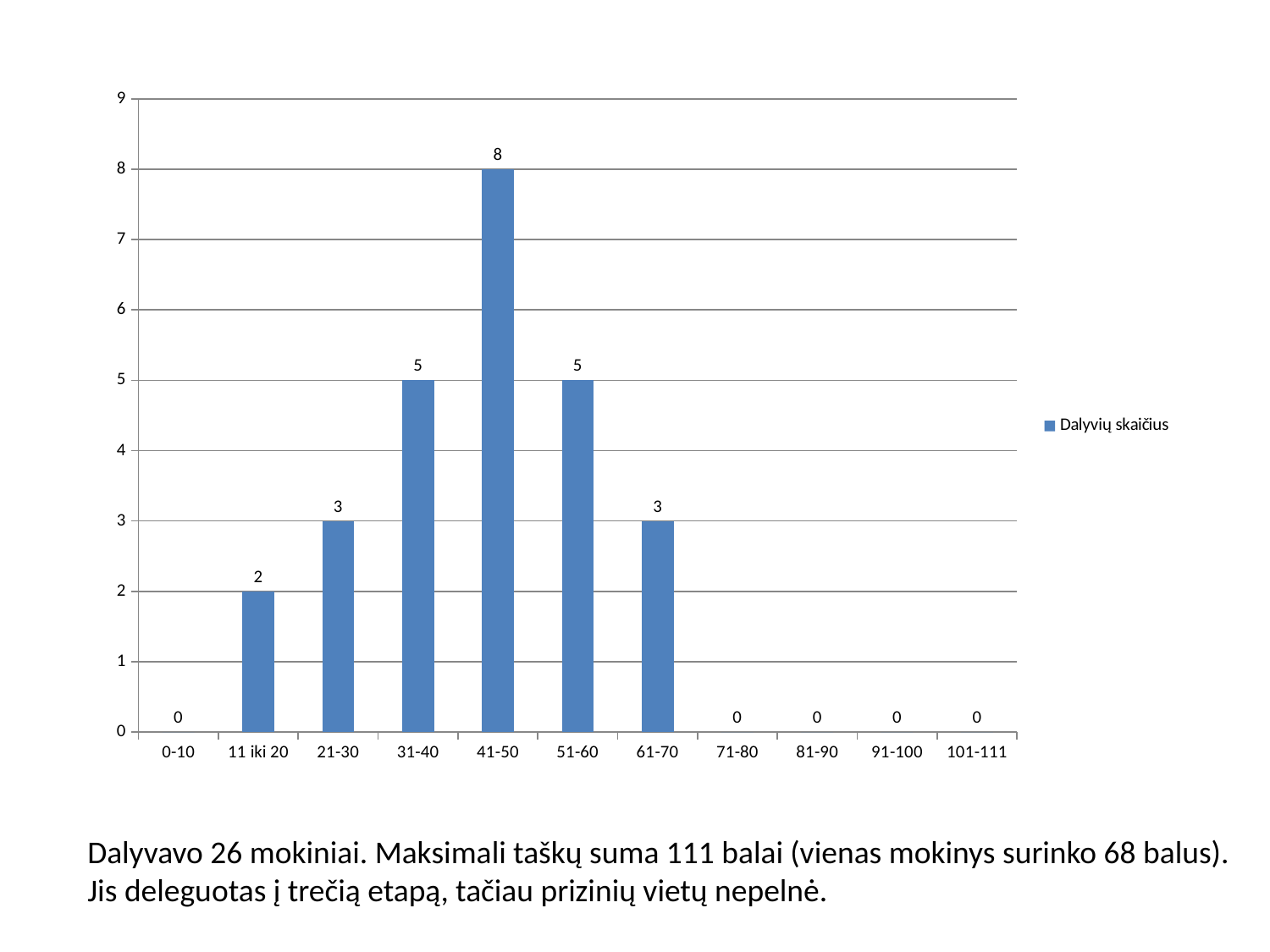
What kind of chart is shown on the slide? bar chart Which category has the highest value? 41-50 How many categories are shown on the x axis? 11 What is the difference between the values for 41-50 and 31-40? 3 What is the name of the series in the legend? Dalyvių skaičius What is the value for the 41-50 category? 8 Is the value for 41-50 greater or less than 7? greater What is the value for the 11 iki 20 category? 2 What is the value for the 61-70 category? 3 How many series does the legend list? 1 Which is larger, the value for 21-30 or the value for 51-60? 51-60 How many categories have a value of 0? 5